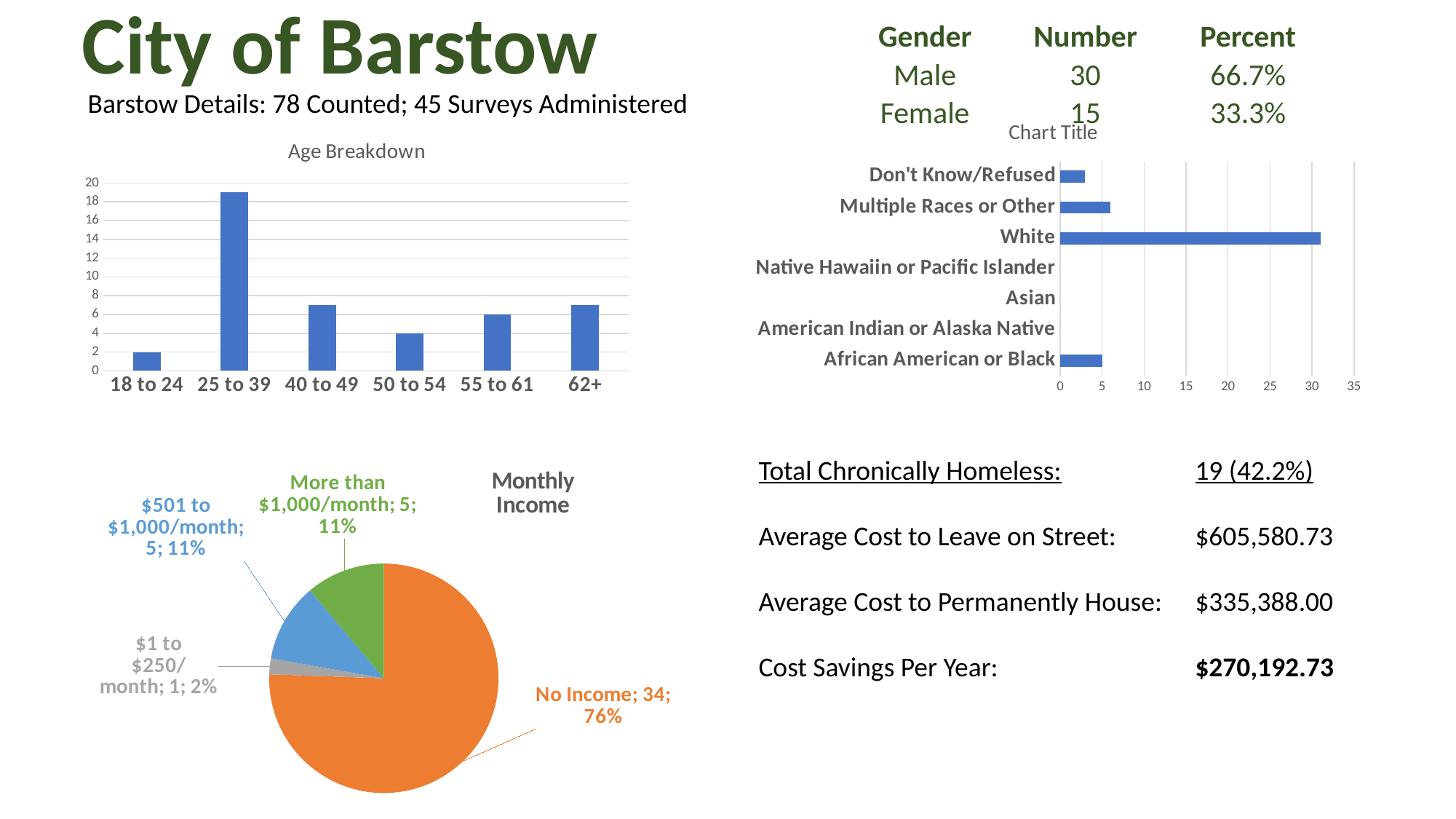
In the race chart on the right (titled Chart Title), is the value for White greater or less than 25? greater In the Monthly Income pie chart, what is the difference between the No Income count and the $501 to $1,000/month count? 29 In the Monthly Income pie chart, what is the count for the $1 to $250/month slice? 1 How many categories are listed in the race chart on the right (titled Chart Title)? 7 How many age groups are shown in the Age Breakdown chart? 6 In the race chart on the right (titled Chart Title), which category has the highest value? White In the Age Breakdown chart, is the value for 25 to 39 greater or less than 10? greater In the Age Breakdown chart, which age group has the highest count? 25 to 39 In the Age Breakdown chart, what is the value for the 55 to 61 age group? 6 What type of chart is the Age Breakdown chart? bar chart In the Monthly Income pie chart, what share of the pie is No Income? 76% In the Age Breakdown chart, which age group has the lowest count? 18 to 24